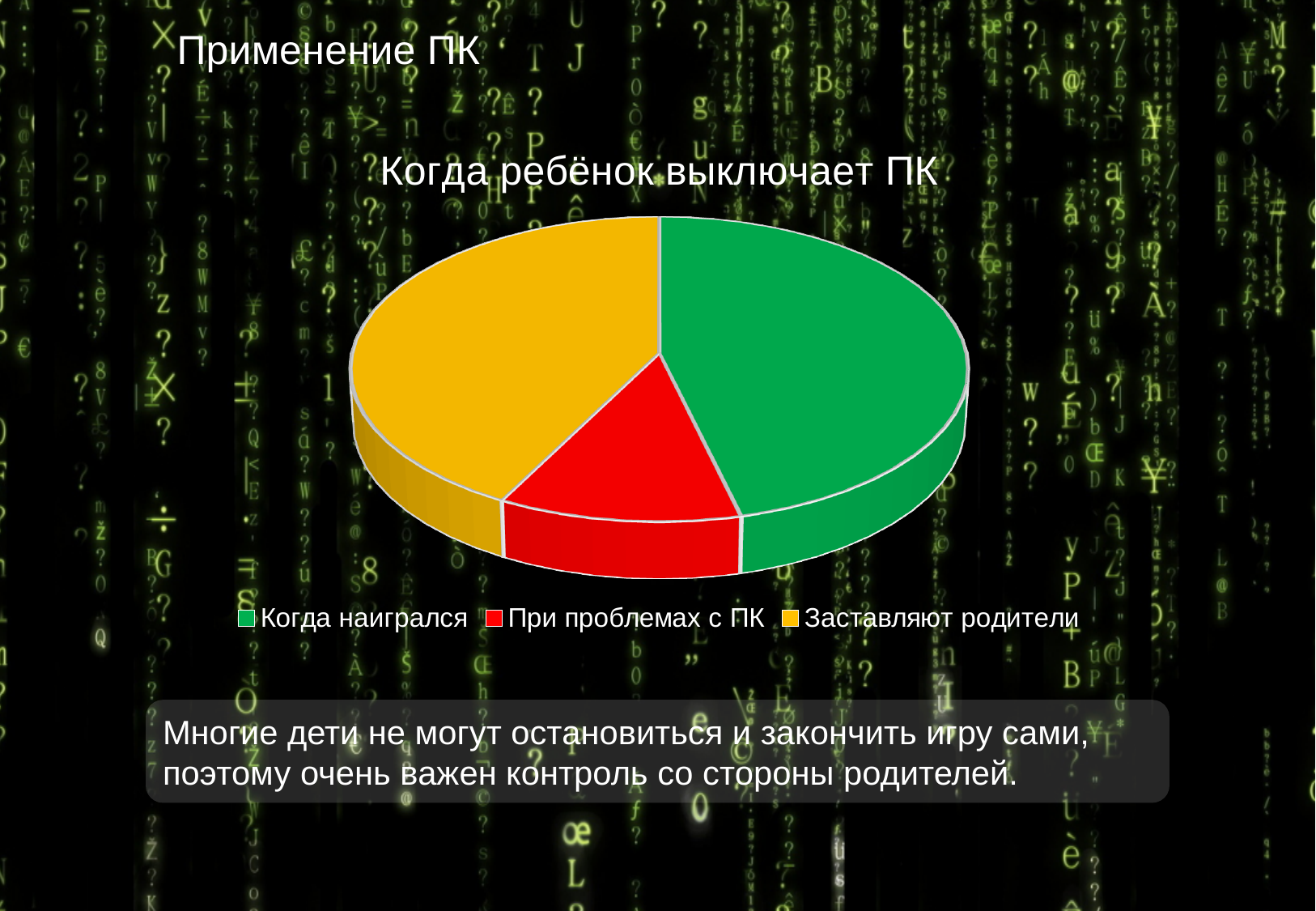
How many slices does the pie chart have? 3 How many entries does the legend list? 3 Which colour represents "Заставляют родители" in the pie chart? yellow What is the title of the chart? Когда ребёнок выключает ПК What kind of chart is shown on the slide? pie chart Which slice is larger: "Заставляют родители" or "При проблемах с ПК"? Заставляют родители Which slice is larger: "Когда наигрался" or "При проблемах с ПК"? Когда наигрался Which category has the smallest slice of the pie? При проблемах с ПК